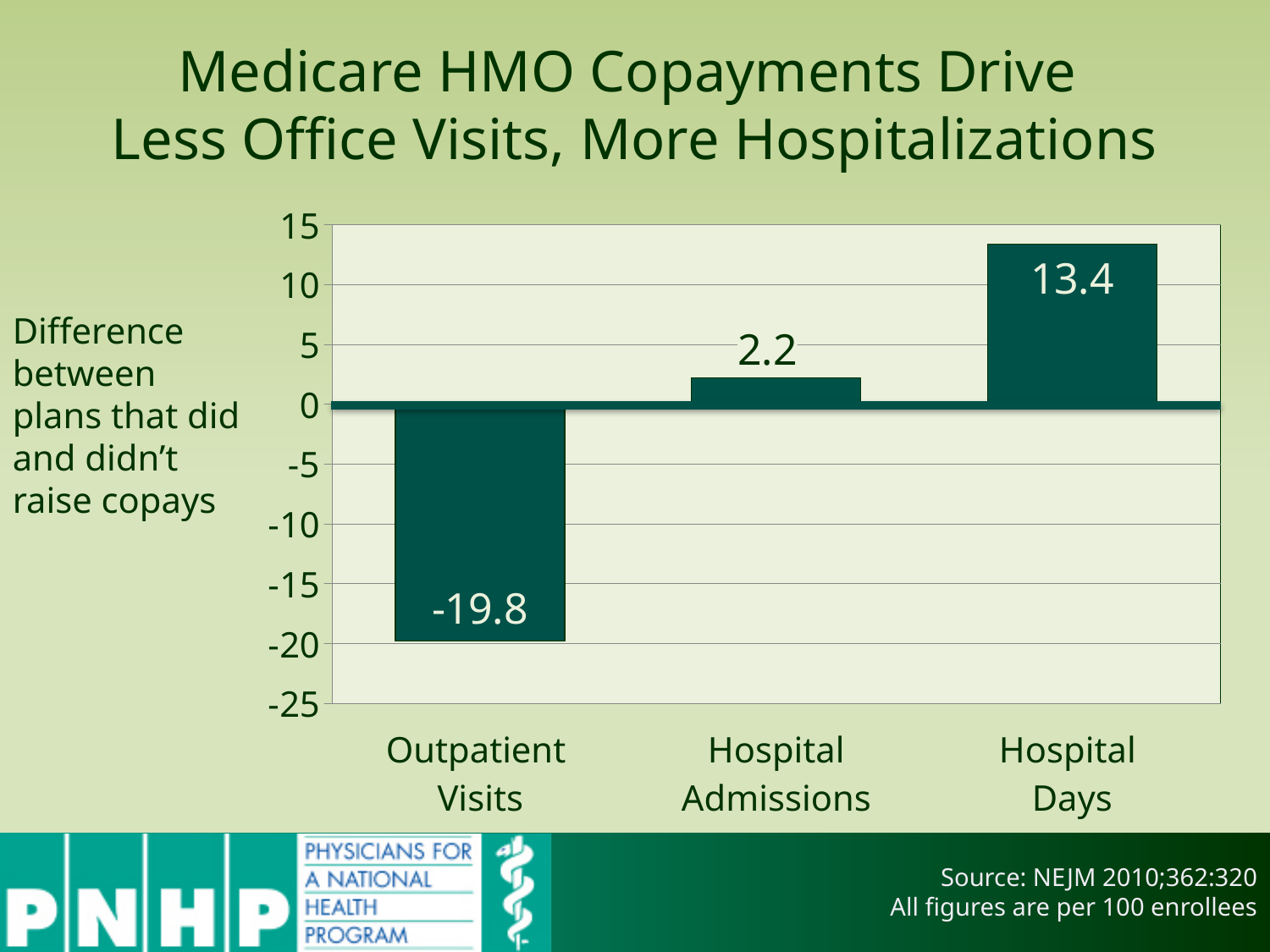
Which is larger, the value for Hospital Admissions or the value for Hospital Days? Hospital Days What is the value for Hospital Admissions? 2.2 According to the note on the slide, what unit are all figures expressed in? Per 100 enrollees How many categories are shown on the chart? 3 Which category has the lowest value? Outpatient Visits What kind of chart is shown on the slide? Bar chart Which category has the highest value? Hospital Days What is the value for Outpatient Visits? -19.8 What is the value for Hospital Days? 13.4 What is the difference between the values for Hospital Days and Hospital Admissions? 11.2 Is the value for Hospital Days greater or less than 10? greater Is the value for Outpatient Visits greater or less than -15? less